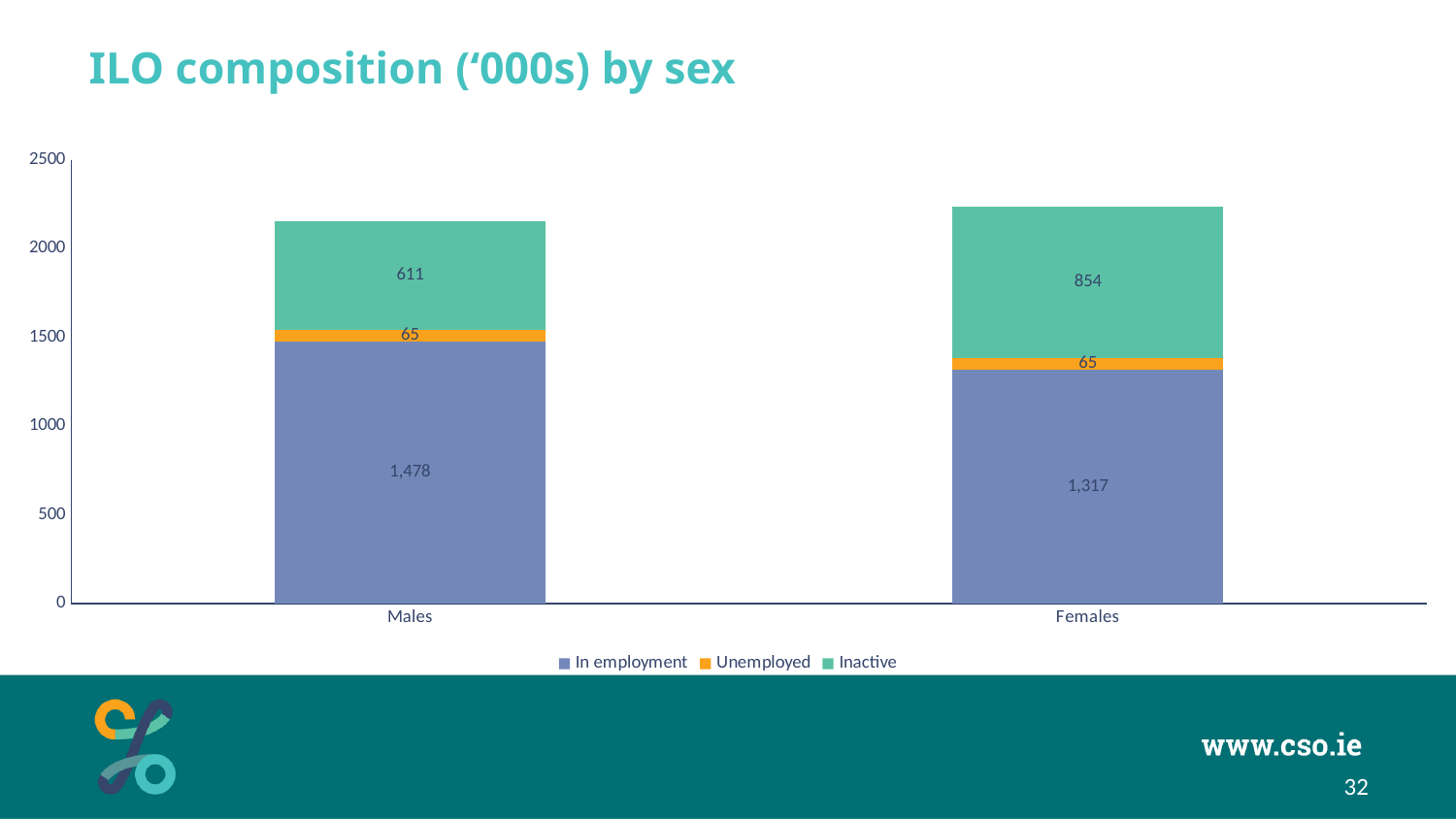
What is the value for Inactive for Females? 854 What is the value for Unemployed for Females? 65 What is the difference between the Inactive values for Females and Males? 243 What is the value for In employment for Males? 1,478 What is the total of the stacked bar for Males? 2,154 What is the total of the stacked bar for Females? 2,236 Which category has the higher In employment value, Males or Females? Males How many series does the legend list? 3 Which category has the higher Inactive value, Males or Females? Females What kind of chart is shown on the slide? Stacked bar chart How many categories are shown on the x axis? 2 What is the difference between the In employment values for Males and Females? 161